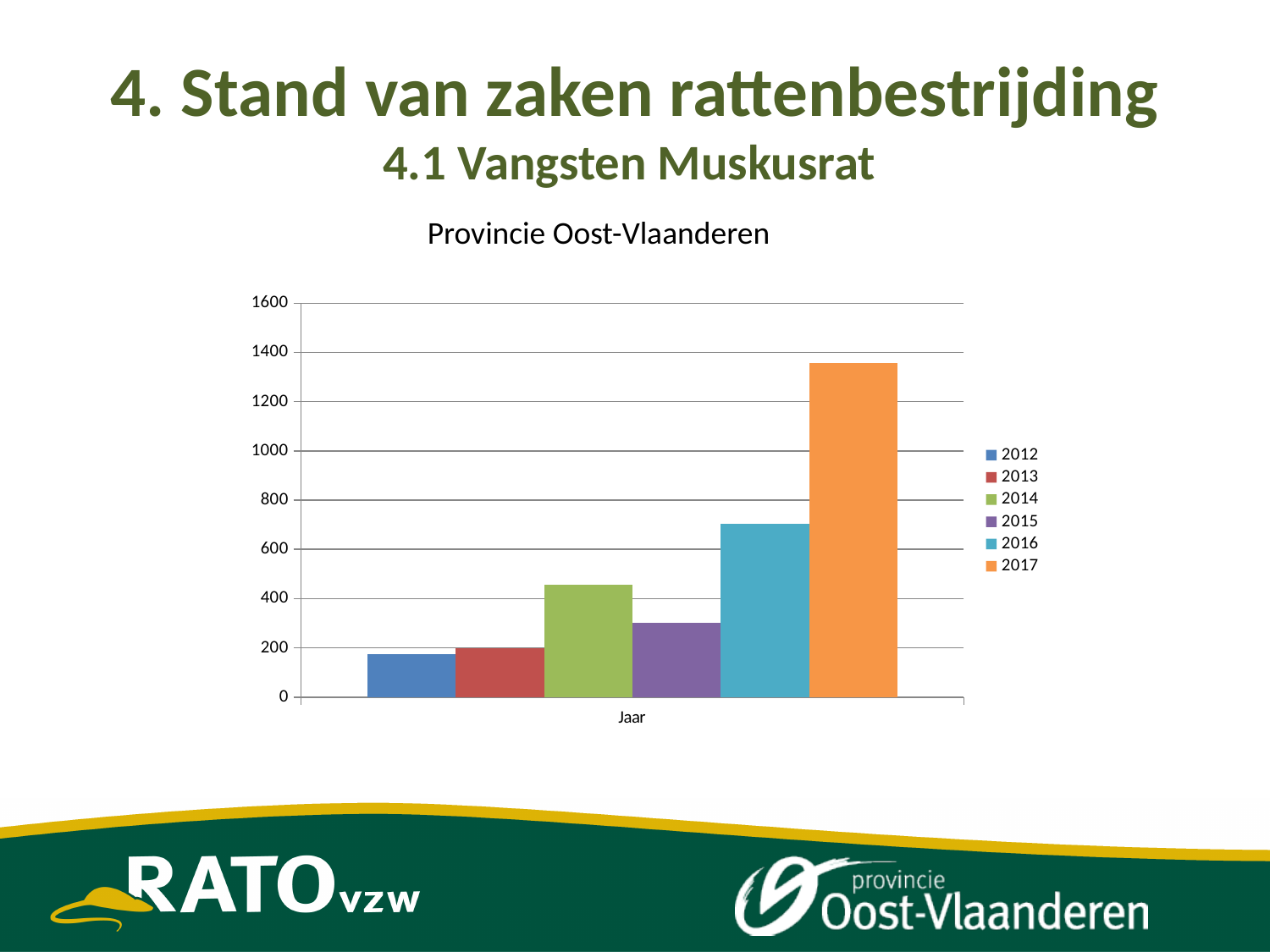
Is the value for 2016 greater or less than 600? greater What kind of chart is shown on the slide? bar chart Is the value for 2014 greater or less than 600? less What is the title of the chart? Provincie Oost-Vlaanderen How many bars are plotted in the chart? 6 Is the value for 2017 greater or less than 1200? greater Which is larger, the value for 2016 or the value for 2014? 2016 Which is larger, the value for 2014 or the value for 2015? 2014 Which year has the highest bar in the chart? 2017 How many entries does the chart's legend list? 6 What label is shown on the horizontal axis of the chart? Jaar